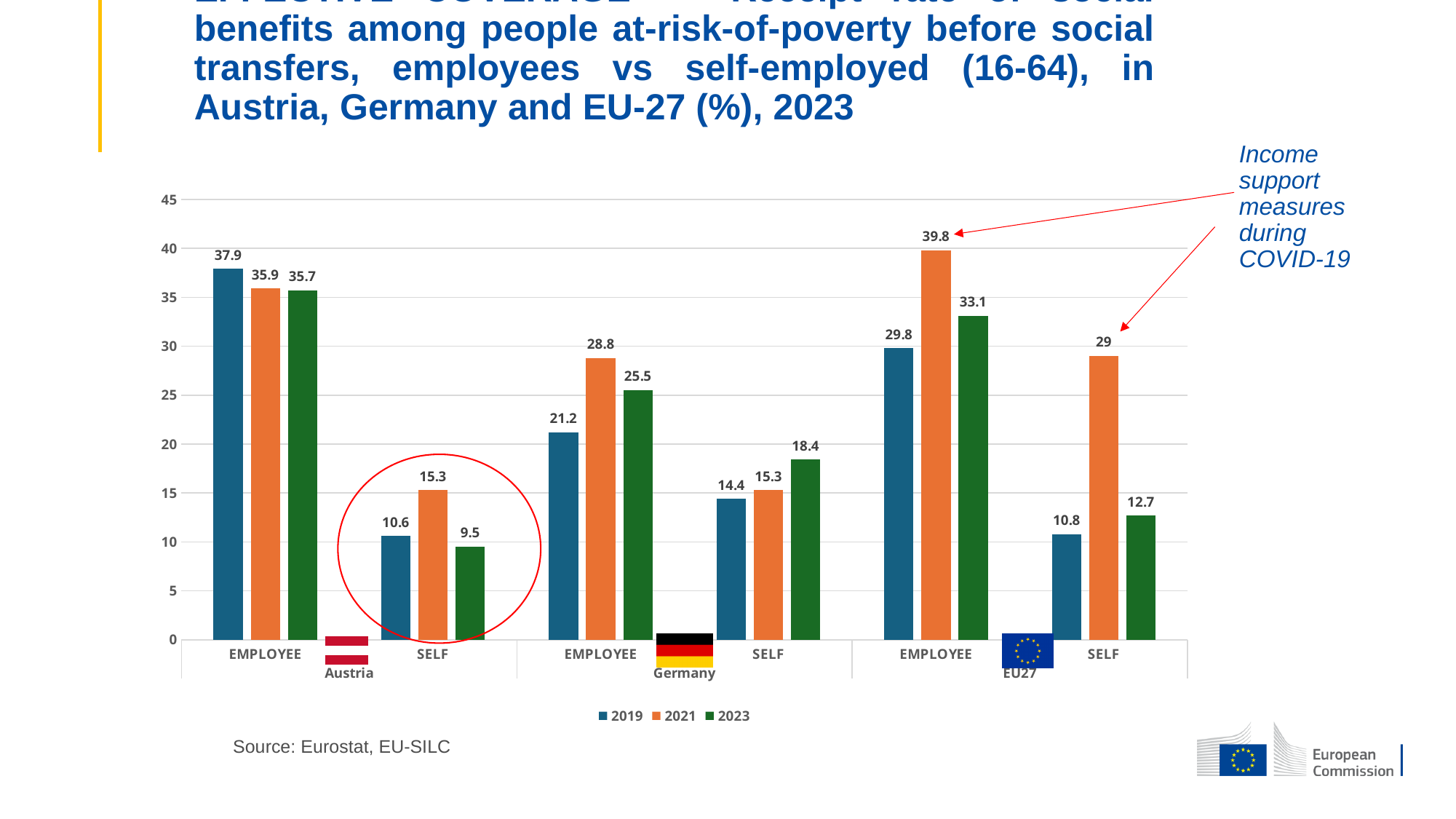
How many series does the legend list? 3 What is the 2021 value for employees in the EU27? 39.8 What is the 2021 value for the self-employed in Austria? 15.3 What is the 2023 value for employees in Germany? 25.5 What is the 2019 value for employees in Austria? 37.9 What kind of chart is shown on the slide? Bar chart Which bar on the chart has the highest value? EU27 employees, 2021 Which bar on the chart has the lowest value? Austria self-employed, 2023 Do the values for the self-employed in Germany rise or fall from 2019 to 2023? Rise Which is larger: the 2023 value for the self-employed in Germany or in the EU27? Germany What is the source given for the chart data? Eurostat, EU-SILC What is the difference between the 2023 values for employees and the self-employed in Austria? 26.2